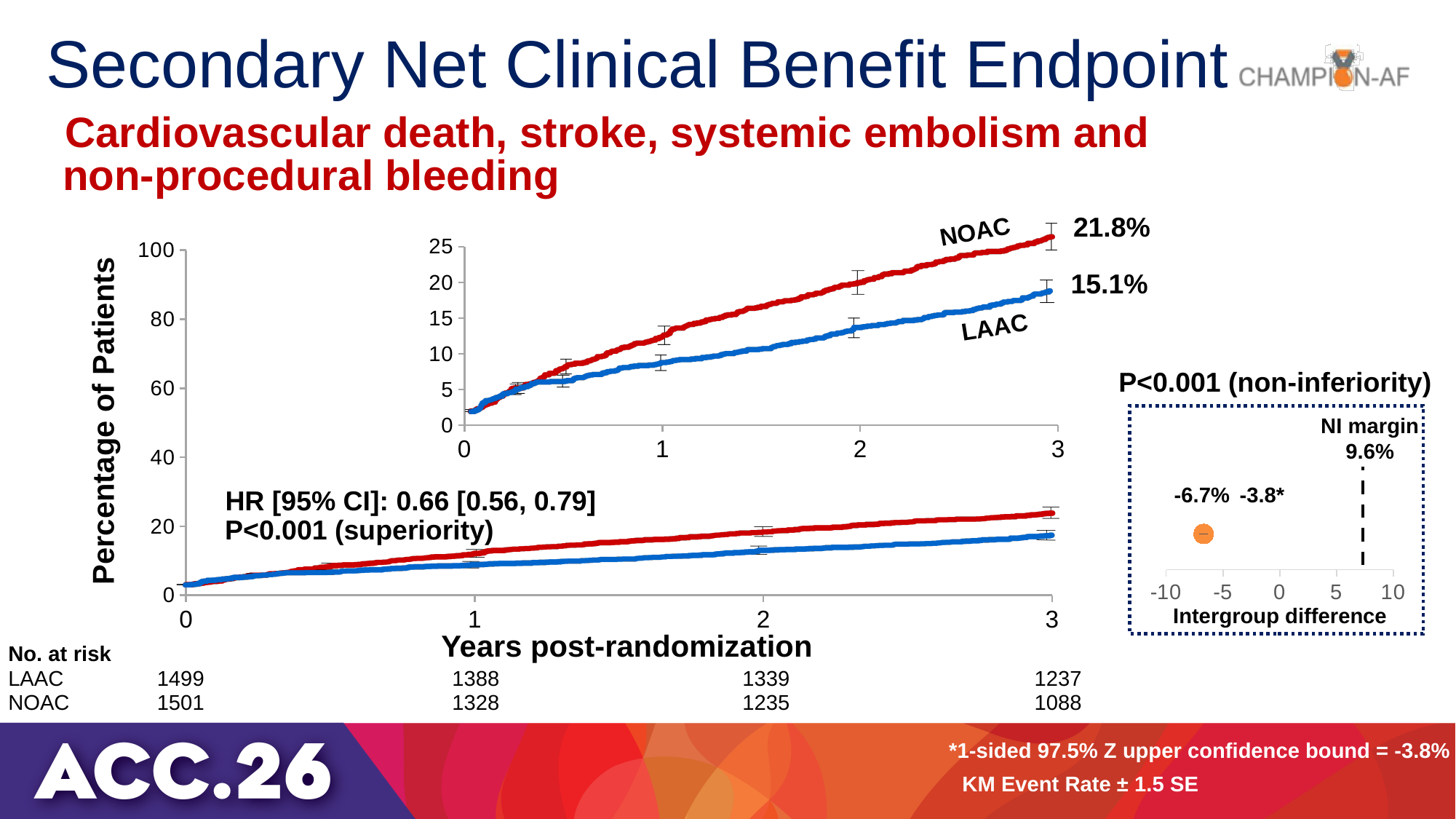
In the No. at risk table, how many LAAC patients were at risk at 3 years? 1237 In the intergroup difference plot, what is the point estimate of the intergroup difference? -6.7% Do the curves in the Kaplan-Meier chart rise or fall over the years post-randomization? rise In the Kaplan-Meier chart, what is the 3-year event rate labelled for the NOAC curve? 21.8% What hazard ratio is printed on the Kaplan-Meier chart? 0.66 In the inset chart, is the NOAC value at 2 years greater or less than 15? greater In the Kaplan-Meier chart, what is the 3-year event rate labelled for the LAAC curve? 15.1% In the Kaplan-Meier chart, what is the difference between the NOAC and LAAC 3-year event rates? 6.7 percentage points In the Kaplan-Meier chart, which group has the higher event rate at 3 years, NOAC or LAAC? NOAC In the No. at risk table, how many NOAC patients were at risk at year 0? 1501 What is the x-axis label of the main Kaplan-Meier chart? Years post-randomization In the intergroup difference plot, what is the NI margin? 9.6%